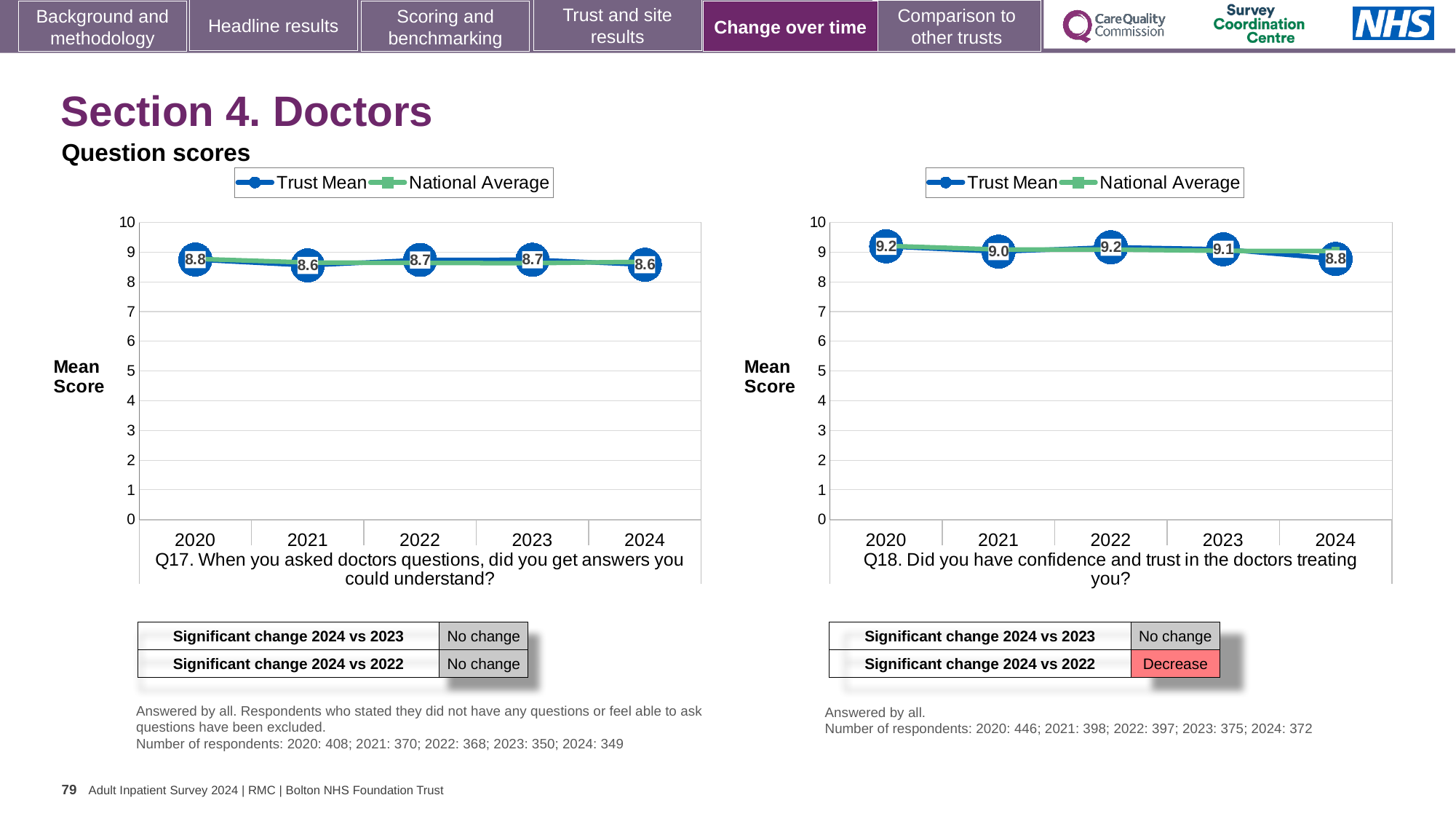
How many years are plotted on the x axis of the Q18 chart? 5 In the Q18 chart, what is the Trust Mean score for 2024? 8.8 What kind of chart is used for Q18? line chart In the Q17 chart, is the Trust Mean score for 2021 larger or smaller than the score for 2022? smaller In the Q17 chart, which year has the highest Trust Mean score? 2020 In the Q18 chart, what is the Trust Mean score for 2022? 9.2 In the Q18 chart, does the Trust Mean score rise or fall from 2023 to 2024? fall How many series does the legend of the Q17 chart list? 2 In the Q17 chart, what is the Trust Mean score for 2024? 8.6 In the Q17 chart, what is the Trust Mean score for 2020? 8.8 In the Q18 chart, what is the difference between the Trust Mean scores for 2020 and 2024? 0.4 In the Q18 chart, which year has the lowest Trust Mean score? 2024